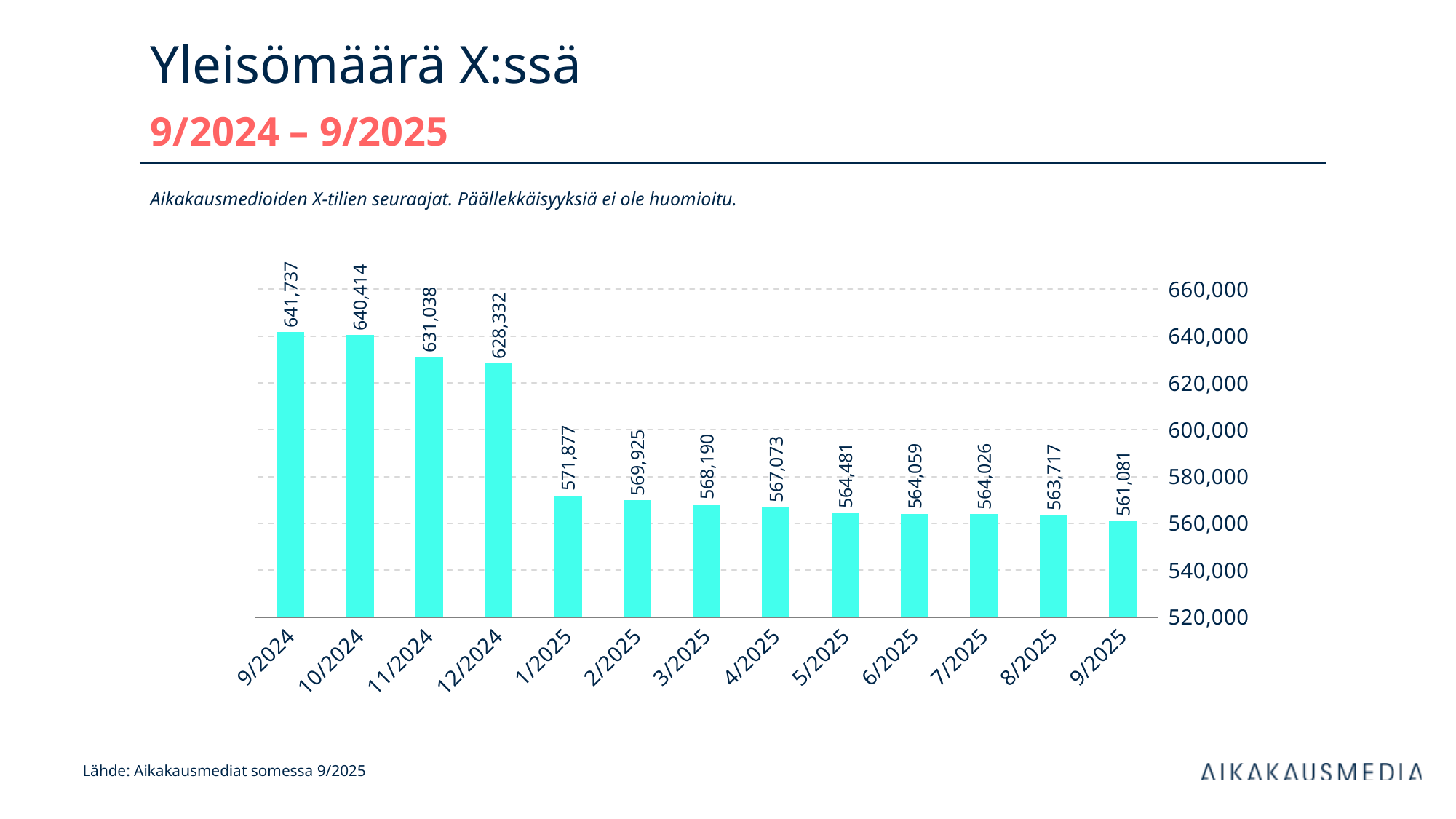
Which month has the lowest value? 9/2025 What is the difference between the values for 9/2024 and 9/2025? 80,656 What is the value for 1/2025? 571,877 Is the value for 2/2025 greater or less than 600,000? less What is the value for 9/2024? 641,737 What kind of chart is shown on the slide? bar chart What is the difference between the values for 12/2024 and 1/2025? 56,455 Which month has the highest value? 9/2024 What is the value for 9/2025? 561,081 Do the values generally rise or fall from 9/2024 to 9/2025? fall How many months are shown on the x axis? 13 Which is larger, the value for 11/2024 or the value for 12/2024? 11/2024